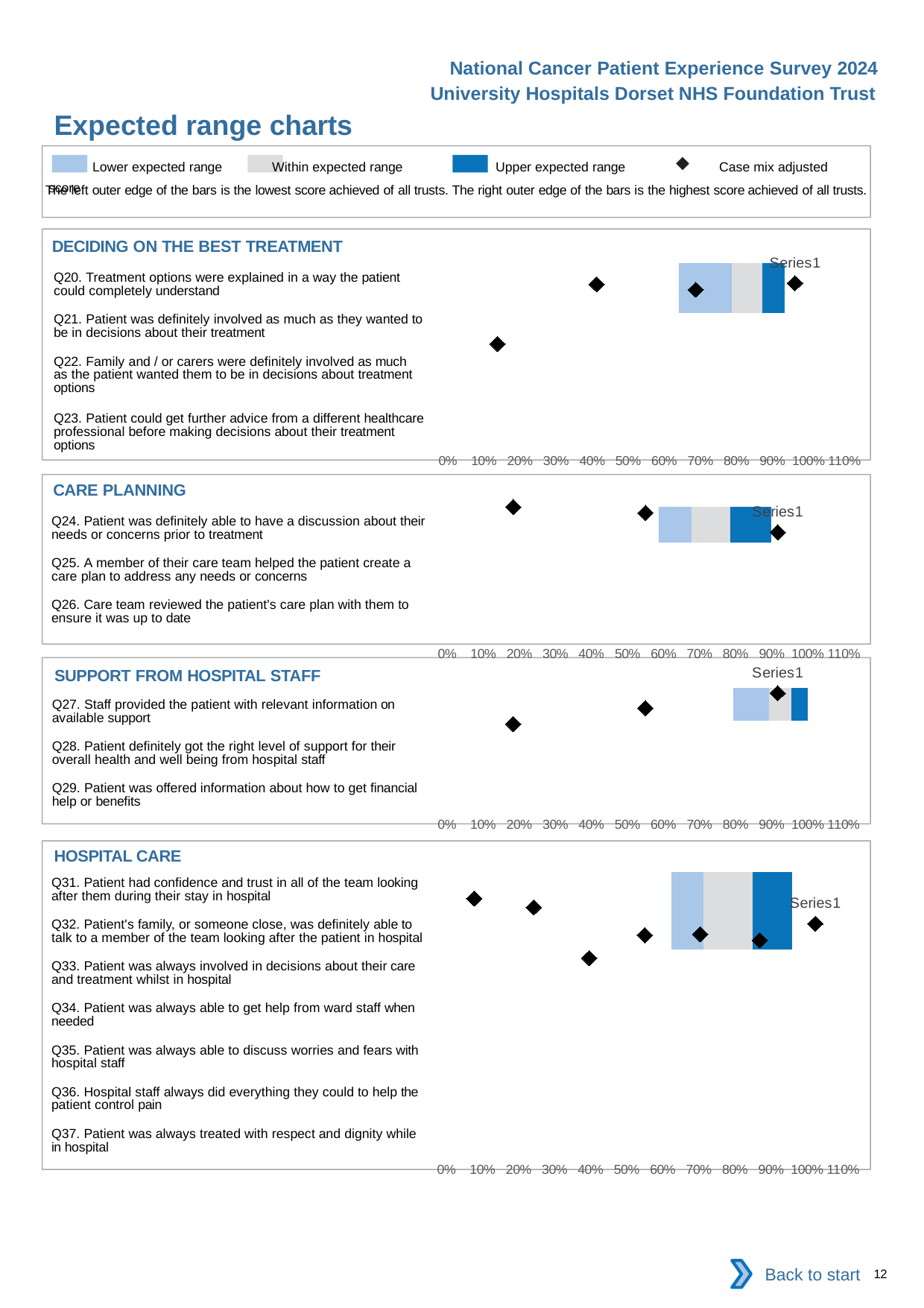
How many entries does the legend at the top of the slide list? 4 Which legend entry is shown in dark blue? Upper expected range What kind of chart is used in the DECIDING ON THE BEST TREATMENT section? bar chart What is the highest tick label on the x axis of the HOSPITAL CARE chart? 110% In the DECIDING ON THE BEST TREATMENT chart, is the left edge of the shaded bar greater or less than 50%? greater How many charts are shown on the slide? 4 How many questions are listed in the DECIDING ON THE BEST TREATMENT chart? 4 How many questions are listed in the HOSPITAL CARE chart? 7 In the HOSPITAL CARE chart, is the right edge of the shaded bar greater or less than 90%? greater